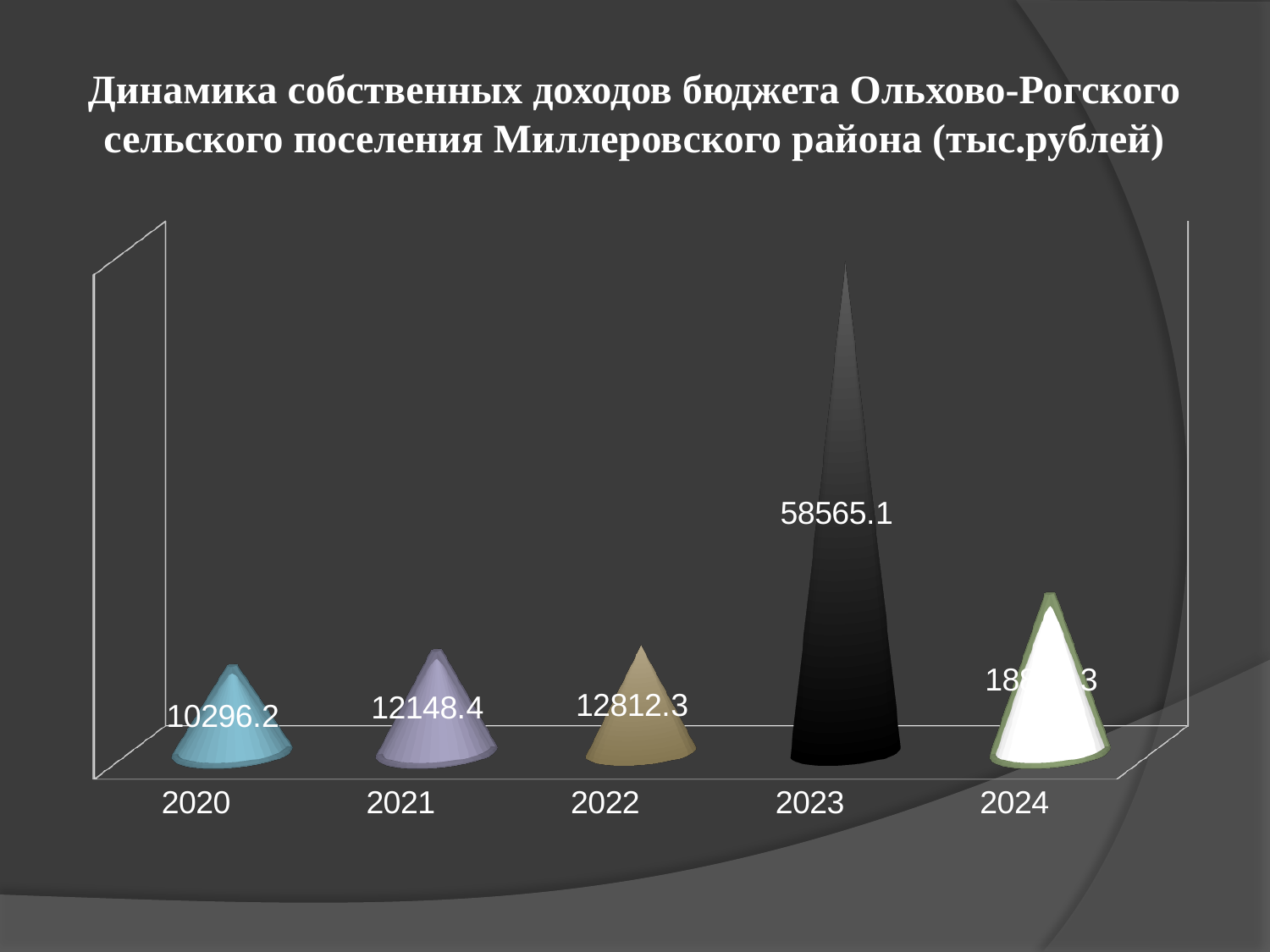
What kind of chart is shown on the slide? bar chart Which is larger, the value for 2024 or the value for 2022? 2024 What is the value for 2023? 58565.1 Do the values rise or fall from 2020 to 2023? rise Which year has the highest value? 2023 How many years are shown on the x axis? 5 Which year has the lowest value? 2020 What is the difference between the values for 2021 and 2020? 1852.2 What is the difference between the values for 2023 and 2022? 45752.8 What is the value for 2020? 10296.2 What is the value for 2022? 12812.3 What is the value for 2021? 12148.4